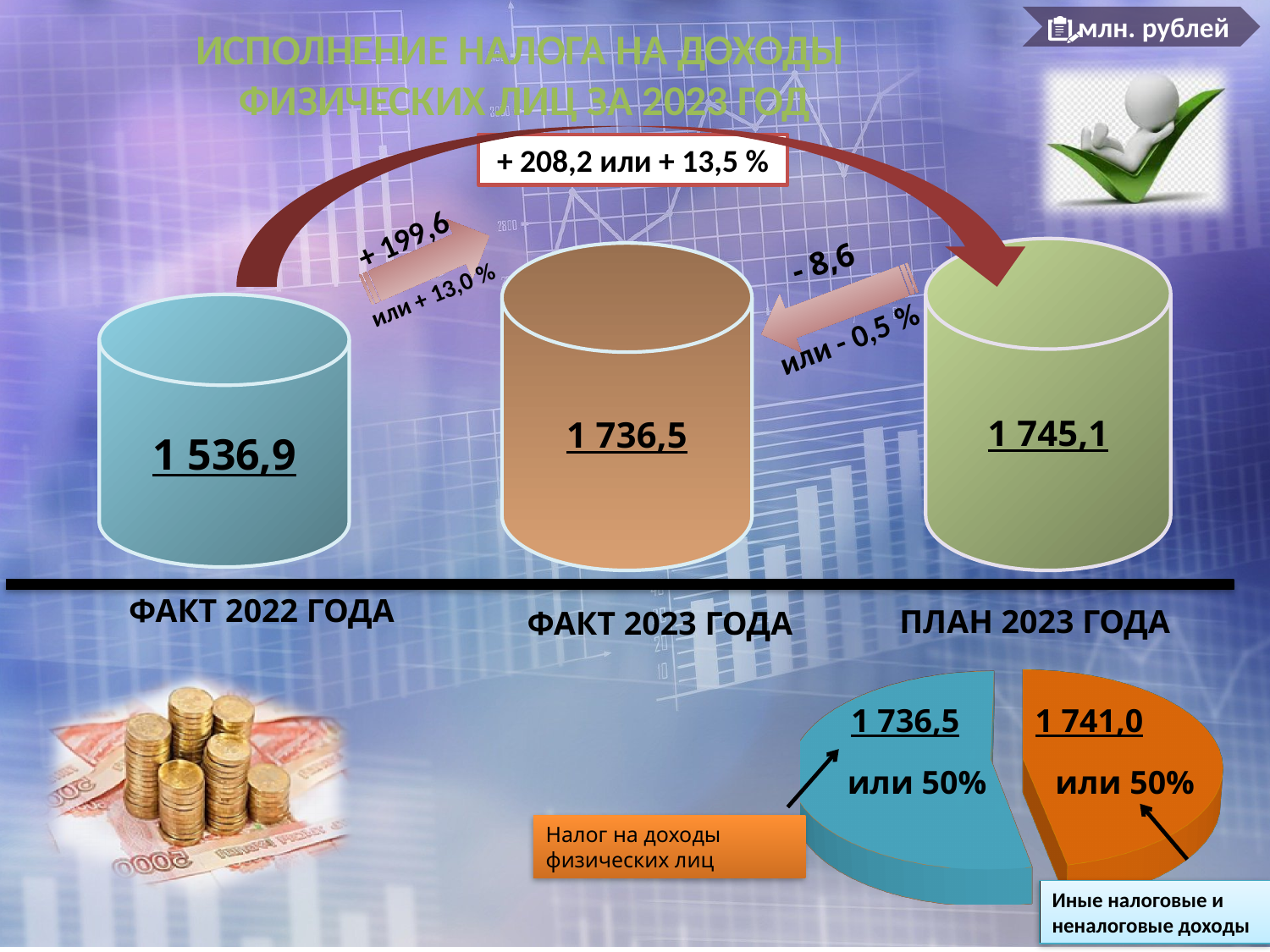
In the top chart, what is the difference between ФАКТ 2023 ГОДА and ФАКТ 2022 ГОДА? 199,6 In the top chart, which category has the lowest value? ФАКТ 2022 ГОДА In the top chart, what is the value for ПЛАН 2023 ГОДА? 1 745,1 In the top chart, which is larger: ФАКТ 2022 ГОДА or ФАКТ 2023 ГОДА? ФАКТ 2023 ГОДА In the top chart, what is the value for ФАКТ 2023 ГОДА? 1 736,5 In the top chart, what is the difference between ПЛАН 2023 ГОДА and ФАКТ 2023 ГОДА? 8,6 In the pie chart at the bottom, what is the value for Иные налоговые и неналоговые доходы? 1 741,0 How many categories are shown in the top chart? 3 In the pie chart at the bottom, what share does Налог на доходы физических лиц have? 50% In the top chart, what is the value for ФАКТ 2022 ГОДА? 1 536,9 What unit of measurement is indicated on the slide? млн. рублей In the pie chart at the bottom, what is the value for Налог на доходы физических лиц? 1 736,5